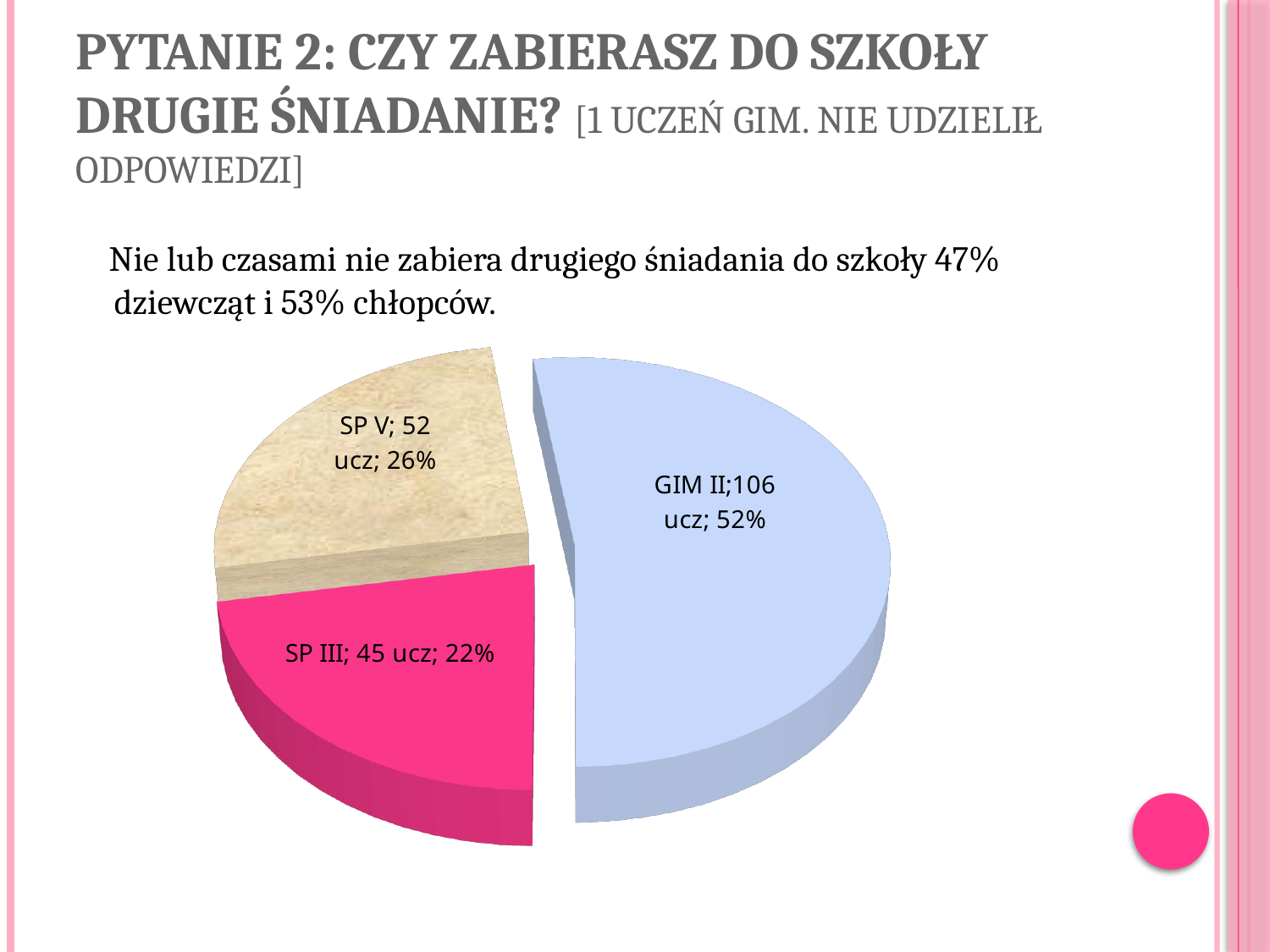
What is the difference in number of students between the GIM II slice and the SP V slice? 54 How many students (ucz) does the GIM II slice represent? 106 How many students (ucz) does the SP V slice represent? 52 What share of the pie does the GIM II slice take? 52% How many students (ucz) does the SP III slice represent? 45 What kind of chart is shown on the slide? pie chart Which slice represents more students, SP V or SP III? SP V What share of the pie does the SP III slice take? 22% How many slices does the pie chart have? 3 What colour is the SP III slice of the pie chart? pink Which slice of the pie chart is the largest? GIM II Which slice of the pie chart is the smallest? SP III